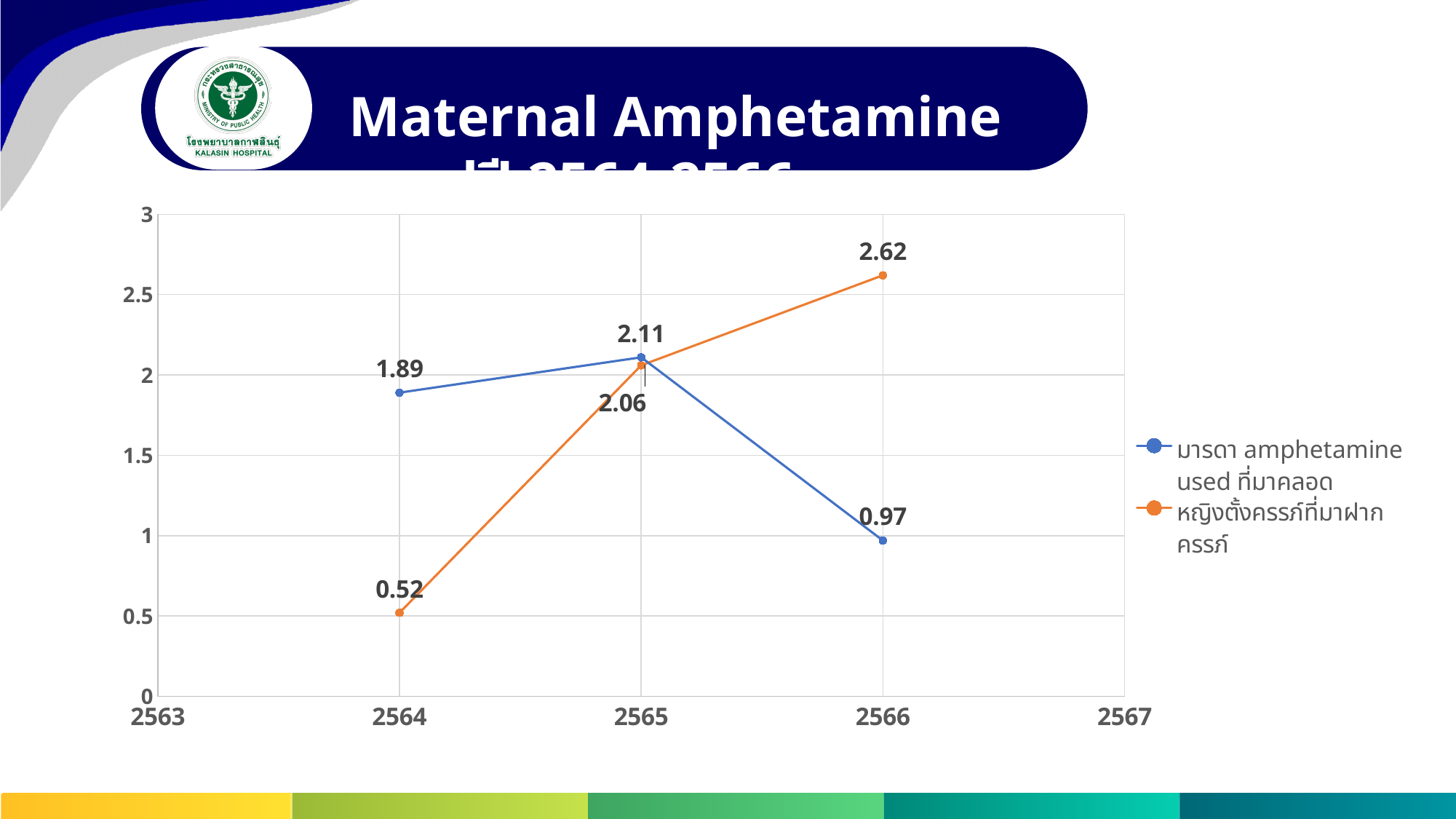
What is the value for หญิงตั้งครรภ์ที่มาฝากครรภ์ in 2566? 2.62 What is the value for หญิงตั้งครรภ์ที่มาฝากครรภ์ in 2564? 0.52 What type of chart is shown on the slide? line chart How many series does the legend list? 2 Does the value for หญิงตั้งครรภ์ที่มาฝากครรภ์ rise or fall from 2564 to 2566? rise Which series has the larger value in 2566, มารดา amphetamine used ที่มาคลอด or หญิงตั้งครรภ์ที่มาฝากครรภ์? หญิงตั้งครรภ์ที่มาฝากครรภ์ In which year is the value for หญิงตั้งครรภ์ที่มาฝากครรภ์ highest? 2566 How many data points are plotted for the มารดา amphetamine used ที่มาคลอด series? 3 What is the value for มารดา amphetamine used ที่มาคลอด in 2564? 1.89 What is the value for มารดา amphetamine used ที่มาคลอด in 2566? 0.97 What is the difference between the หญิงตั้งครรภ์ที่มาฝากครรภ์ values in 2566 and 2564? 2.10 In which year is the value for มารดา amphetamine used ที่มาคลอด lowest? 2566